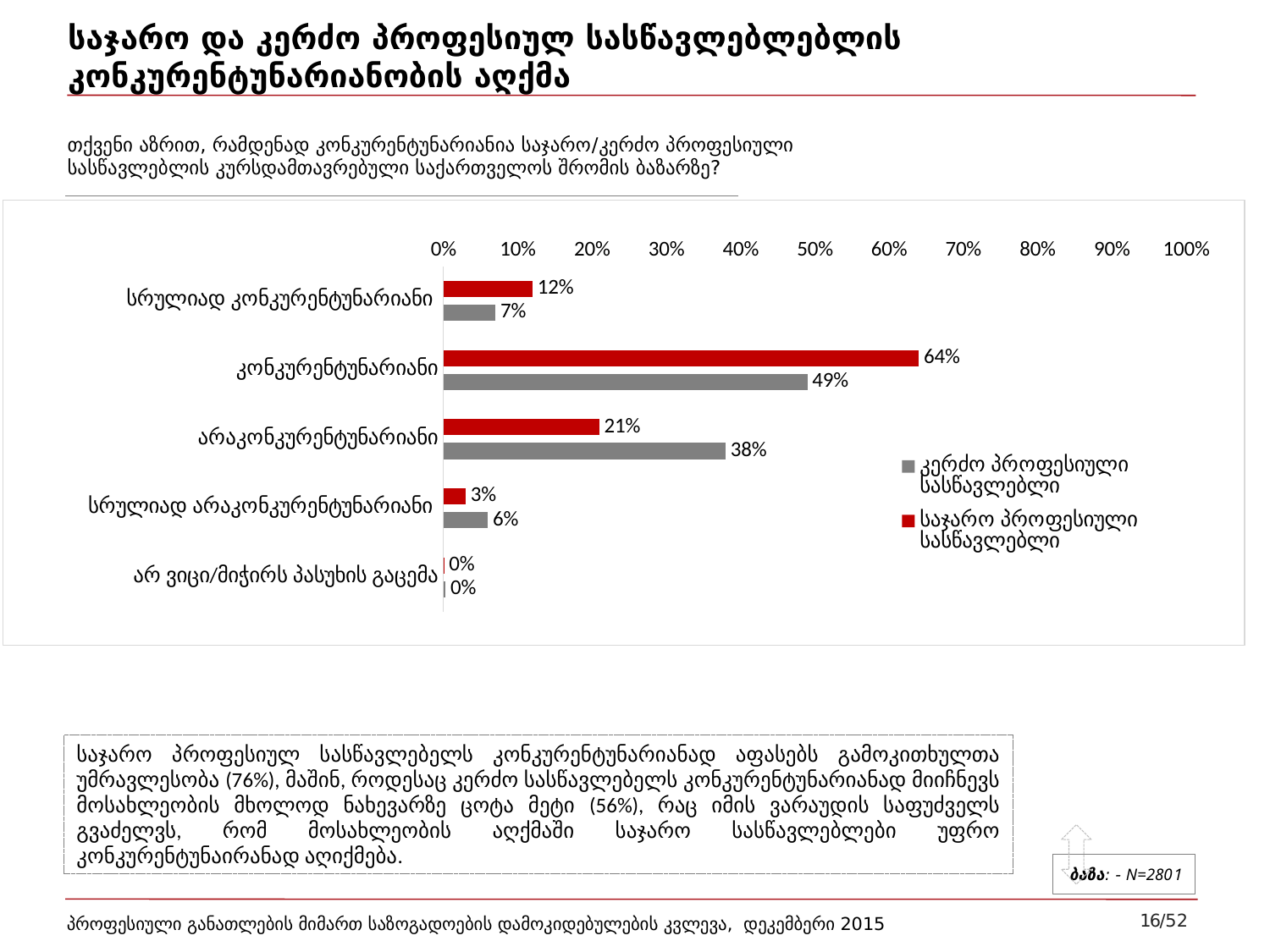
What is the difference between the "საჯარო პროფესიული სასწავლებლი" and "კერძო პროფესიული სასწავლებლი" values in the category "კონკურენტუნარიანი"? 15% How many categories are shown on the chart's vertical axis? 5 In the category "არაკონკურენტუნარიანი", which series has the larger value? კერძო პროფესიული სასწავლებლი What type of chart is shown on the slide? bar chart Which category has the lowest value for "კერძო პროფესიული სასწავლებლი"? არ ვიცი/მიჭირს პასუხის გაცემა Which colour represents the series "საჯარო პროფესიული სასწავლებლი" in the chart? red What is the value for "საჯარო პროფესიული სასწავლებლი" in the category "კონკურენტუნარიანი"? 64% How many series does the chart legend list? 2 Which category has the highest value for "საჯარო პროფესიული სასწავლებლი"? კონკურენტუნარიანი What is the value for "კერძო პროფესიული სასწავლებლი" in the category "არაკონკურენტუნარიანი"? 38% Is the value for "საჯარო პროფესიული სასწავლებლი" in the category "კონკურენტუნარიანი" greater or less than 50%? greater What is the value for "კერძო პროფესიული სასწავლებლი" in the category "სრულიად კონკურენტუნარიანი"? 7%